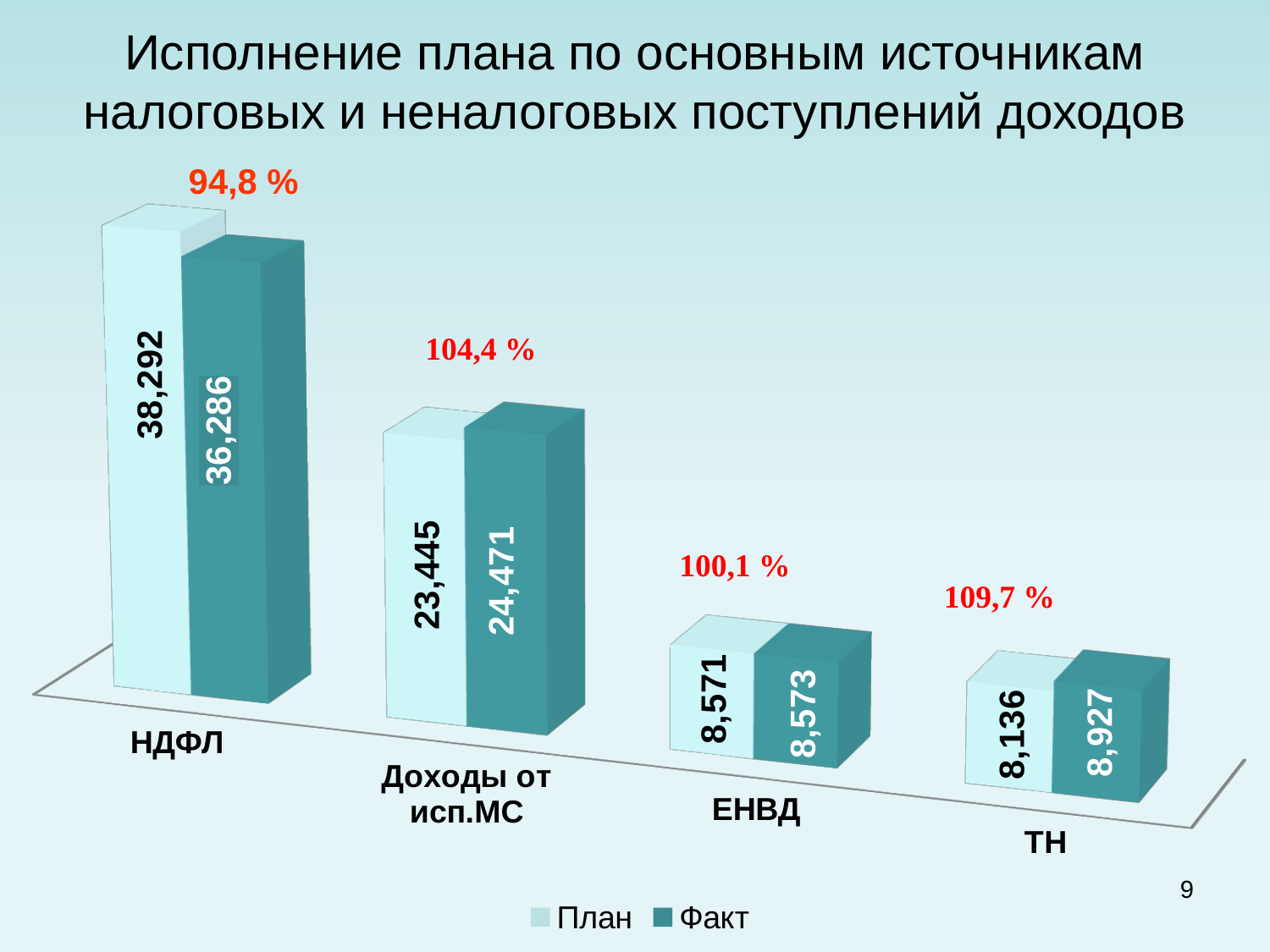
For Доходы от исп.МС, which is larger: План or Факт? Факт How many categories are shown on the x axis? 4 Which category has the highest Факт value? НДФЛ What percentage is shown above the bars for ТН? 109,7 % What is the Факт value for ТН? 8,927 What is the План value for НДФЛ? 38,292 What is the План value for ЕНВД? 8,571 What is the difference between the План and Факт values for НДФЛ? 2,006 How many series does the legend list? 2 Which category has the lowest План value? ТН What is the Факт value for Доходы от исп.МС? 24,471 What kind of chart is shown on the slide? Bar chart